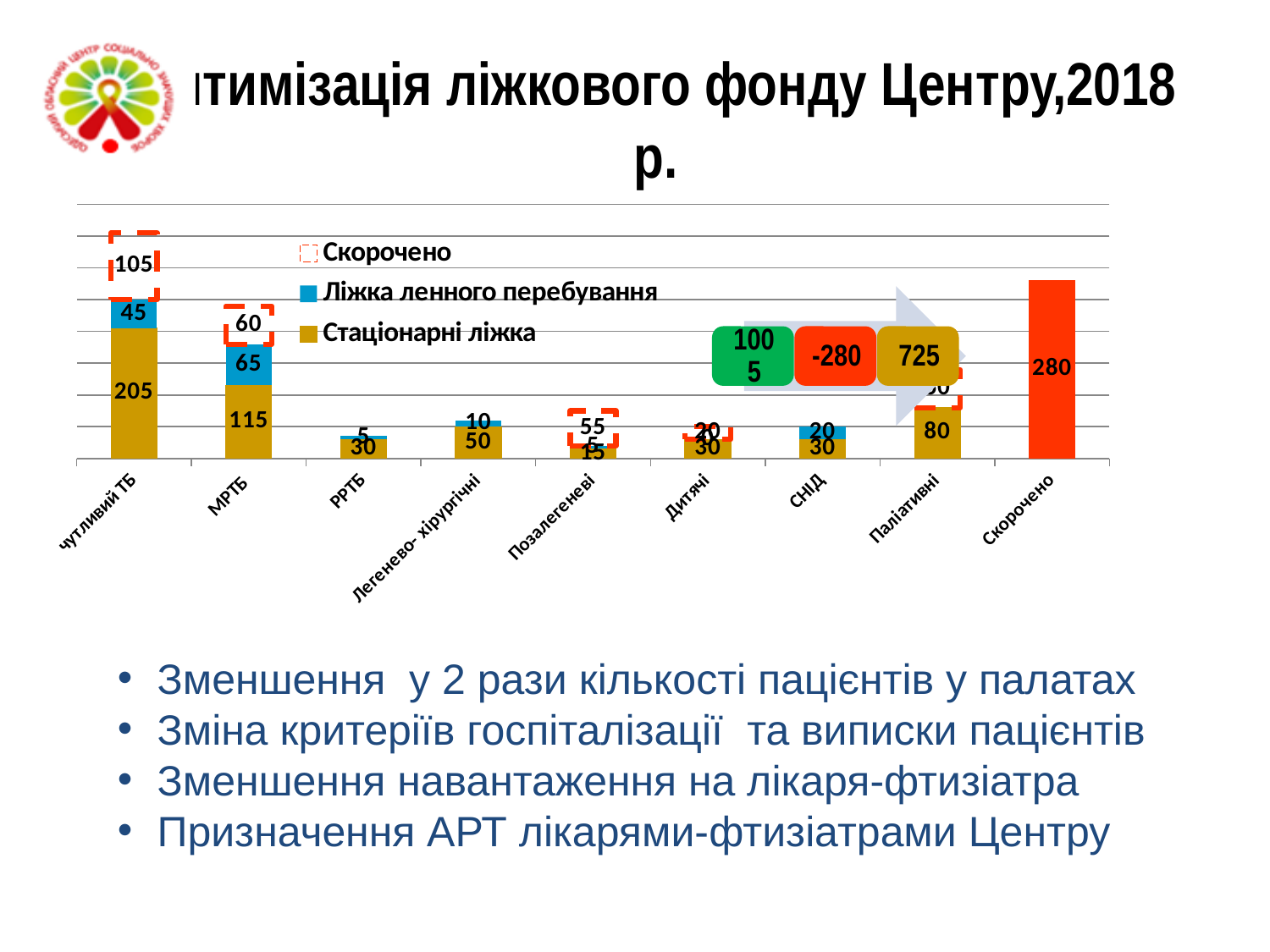
What is the Скорочено value shown for чутливий ТБ? 105 What is the value of Стаціонарні ліжка for чутливий ТБ? 205 Which has more Стаціонарні ліжка: РРТБ or Легенево-хірургічні? Легенево-хірургічні What is the value of Ліжка денного перебування for СНІД? 20 What kind of chart is shown on the slide? Bar chart What is the Скорочено value shown for МРТБ? 60 What is the value of Стаціонарні ліжка for Паліативні? 80 Which category has the highest value of Стаціонарні ліжка? чутливий ТБ What is the difference between the Стаціонарні ліжка values for чутливий ТБ and МРТБ? 90 What value is labelled on the Скорочено bar at the far right of the chart? 280 What is the value of Ліжка денного перебування for МРТБ? 65 How many series does the legend list? 3